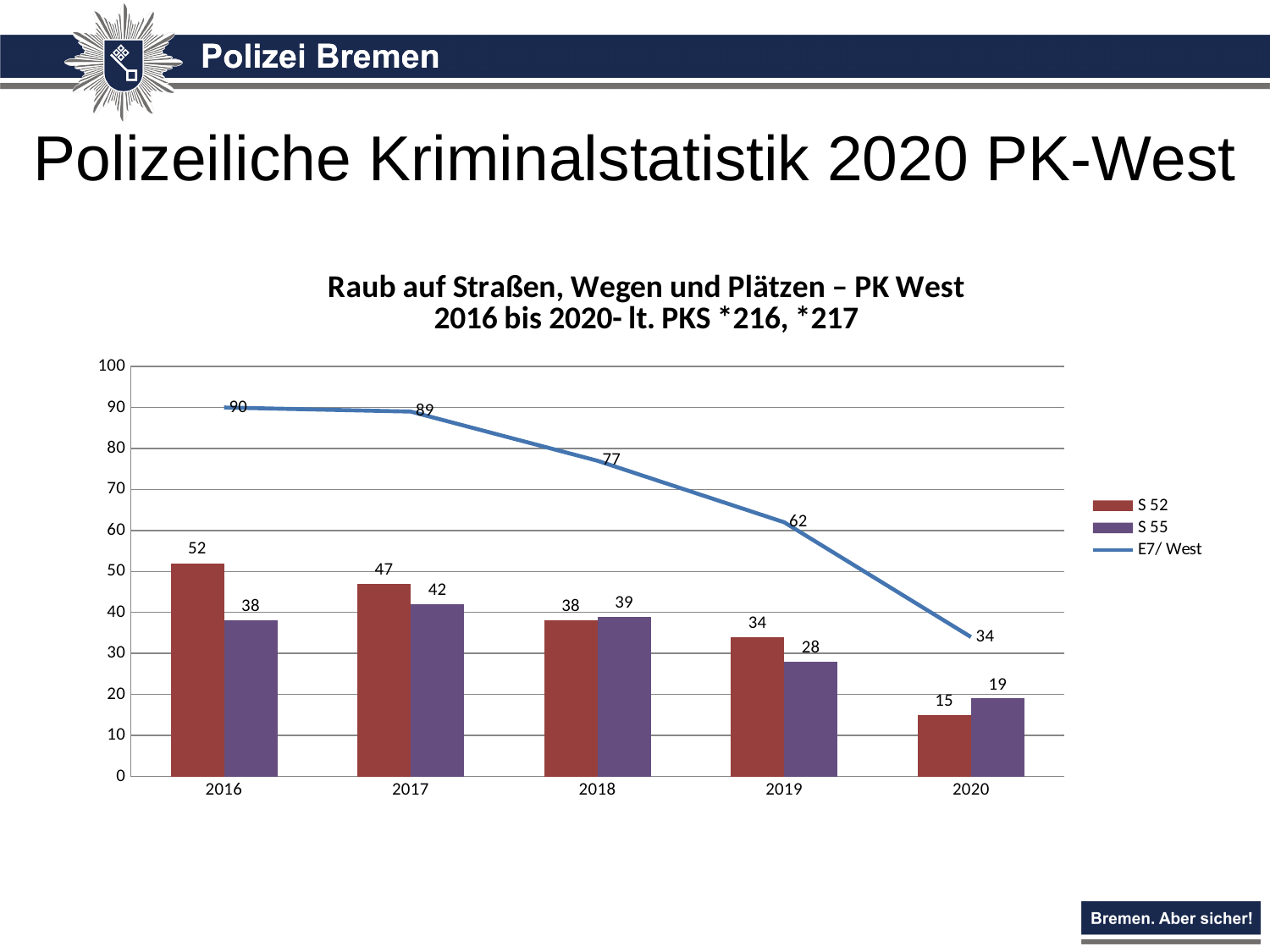
What is the value for E7/ West in 2018? 77 What is the difference between S 52 and S 55 in 2017? 5 In which year is the S 52 value highest? 2016 Does the E7/ West line rise or fall from 2016 to 2020? fall What is the difference between the E7/ West values for 2016 and 2020? 56 Which is larger in 2020, S 52 or S 55? S 55 How many years are shown on the x axis? 5 How many series does the legend list? 3 What is the value for S 55 in 2019? 28 Which series is drawn as a line rather than bars? E7/ West In which year is the E7/ West value lowest? 2020 What is the value for S 52 in 2016? 52